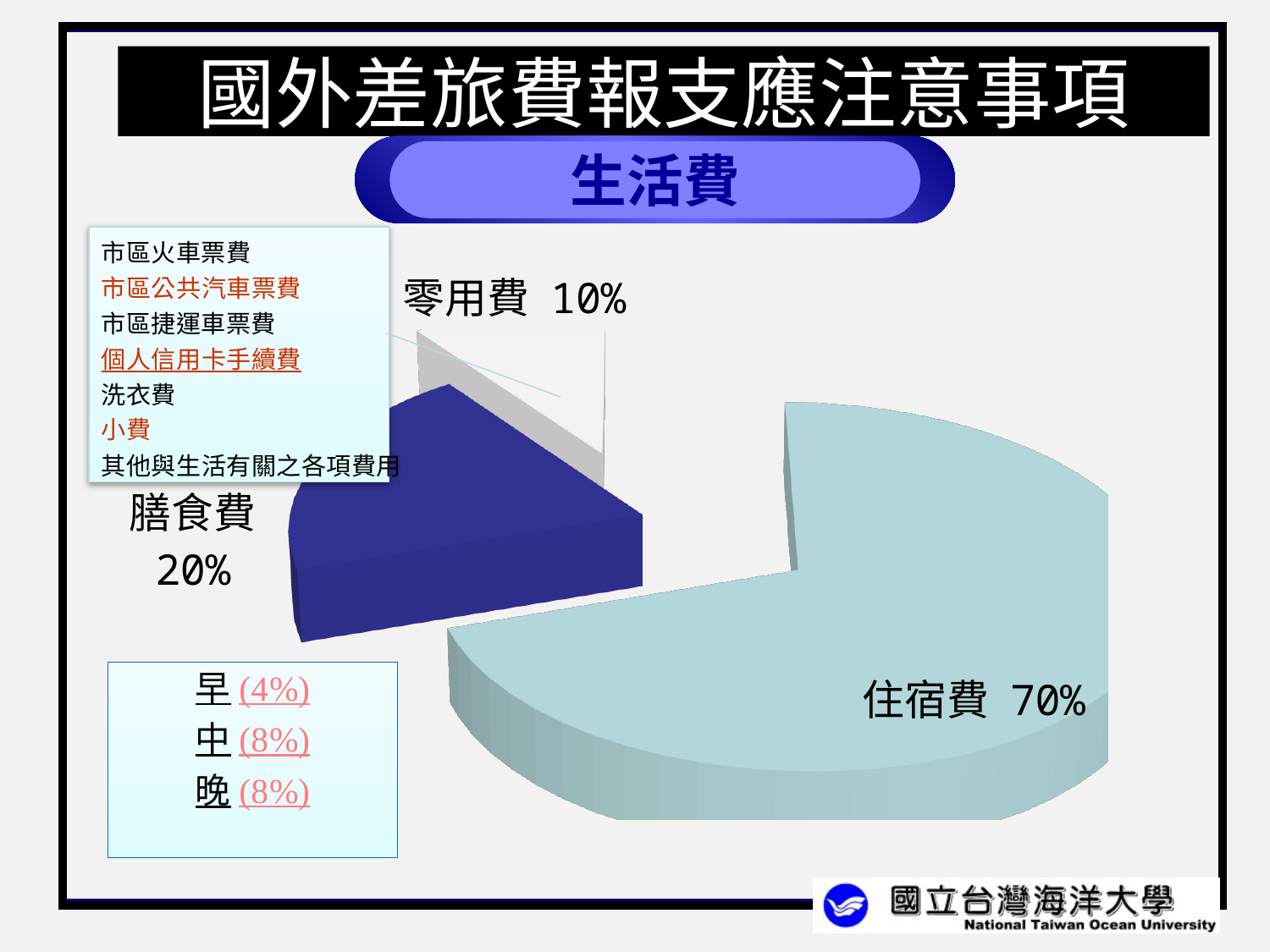
What is the difference in percentage points between 膳食費 and 零用費? 10% What is the title shown above the pie chart? 生活費 What share of the pie does 膳食費 represent? 20% Which category has the largest slice of the pie? 住宿費 Which is larger, the share for 膳食費 or the share for 零用費? 膳食費 What kind of chart is shown on the slide? pie chart What share of the pie does 住宿費 represent? 70% What share of the pie does 零用費 represent? 10% How many slices does the pie chart have? 3 What is the difference in percentage points between 住宿費 and 膳食費? 50% What is the combined share of 膳食費 and 零用費? 30% Which category has the smallest slice of the pie? 零用費